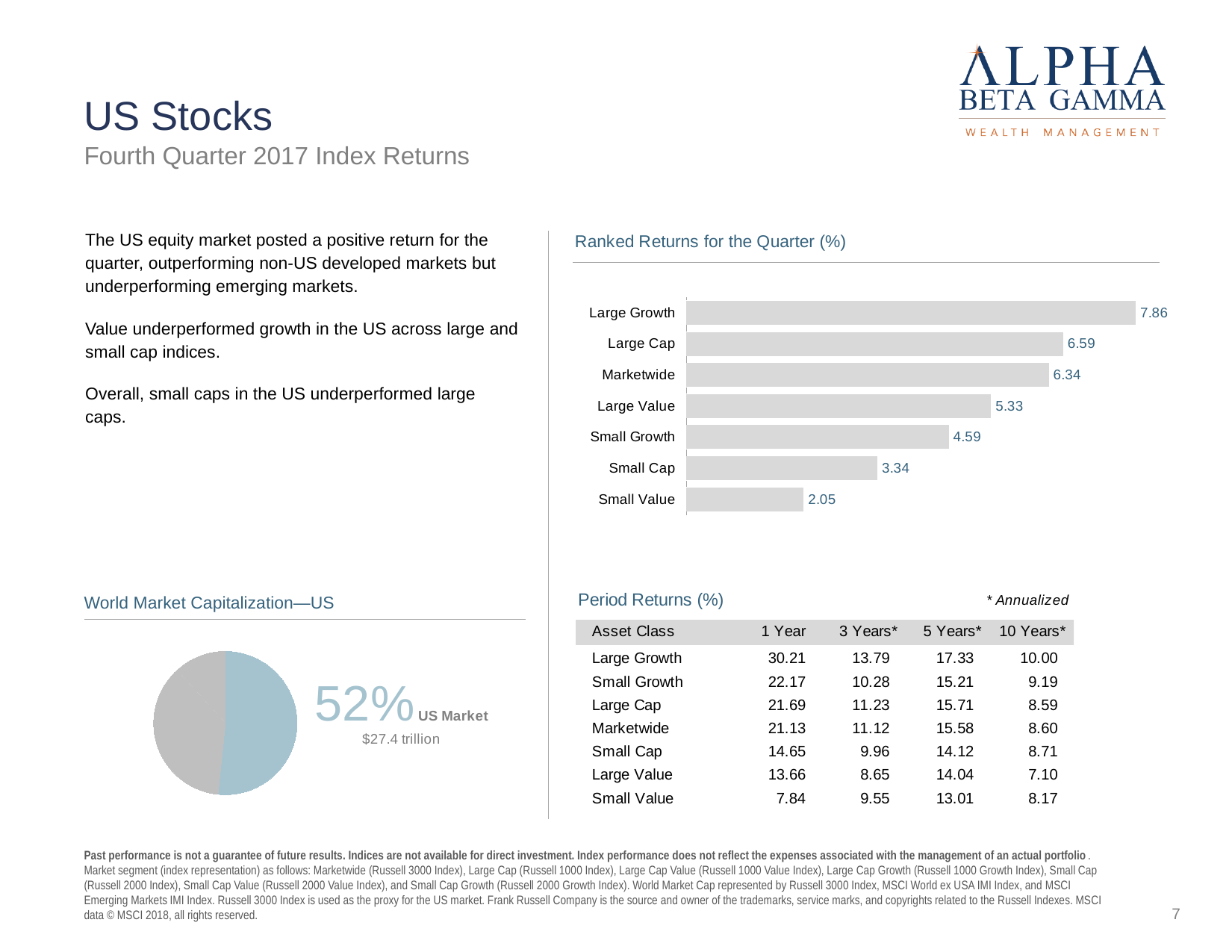
In the 'World Market Capitalization—US' chart, what dollar amount is shown for the US Market? $27.4 trillion In the 'Ranked Returns for the Quarter (%)' chart, what is the value for Small Cap? 3.34 How many categories are shown in the 'Ranked Returns for the Quarter (%)' chart? 7 In the 'Ranked Returns for the Quarter (%)' chart, which is larger, Marketwide or Large Value? Marketwide In the 'World Market Capitalization—US' chart, what share of the pie does the US Market represent? 52% In the 'Ranked Returns for the Quarter (%)' chart, which category has the highest value? Large Growth In the 'Ranked Returns for the Quarter (%)' chart, what is the value for Large Growth? 7.86 In the 'Ranked Returns for the Quarter (%)' chart, what is the value for Small Growth? 4.59 In the 'Ranked Returns for the Quarter (%)' chart, what is the difference between Large Cap and Small Cap? 3.25 What kind of chart is 'Ranked Returns for the Quarter (%)'? Bar chart What kind of chart is 'World Market Capitalization—US'? Pie chart In the 'Ranked Returns for the Quarter (%)' chart, which category has the lowest value? Small Value